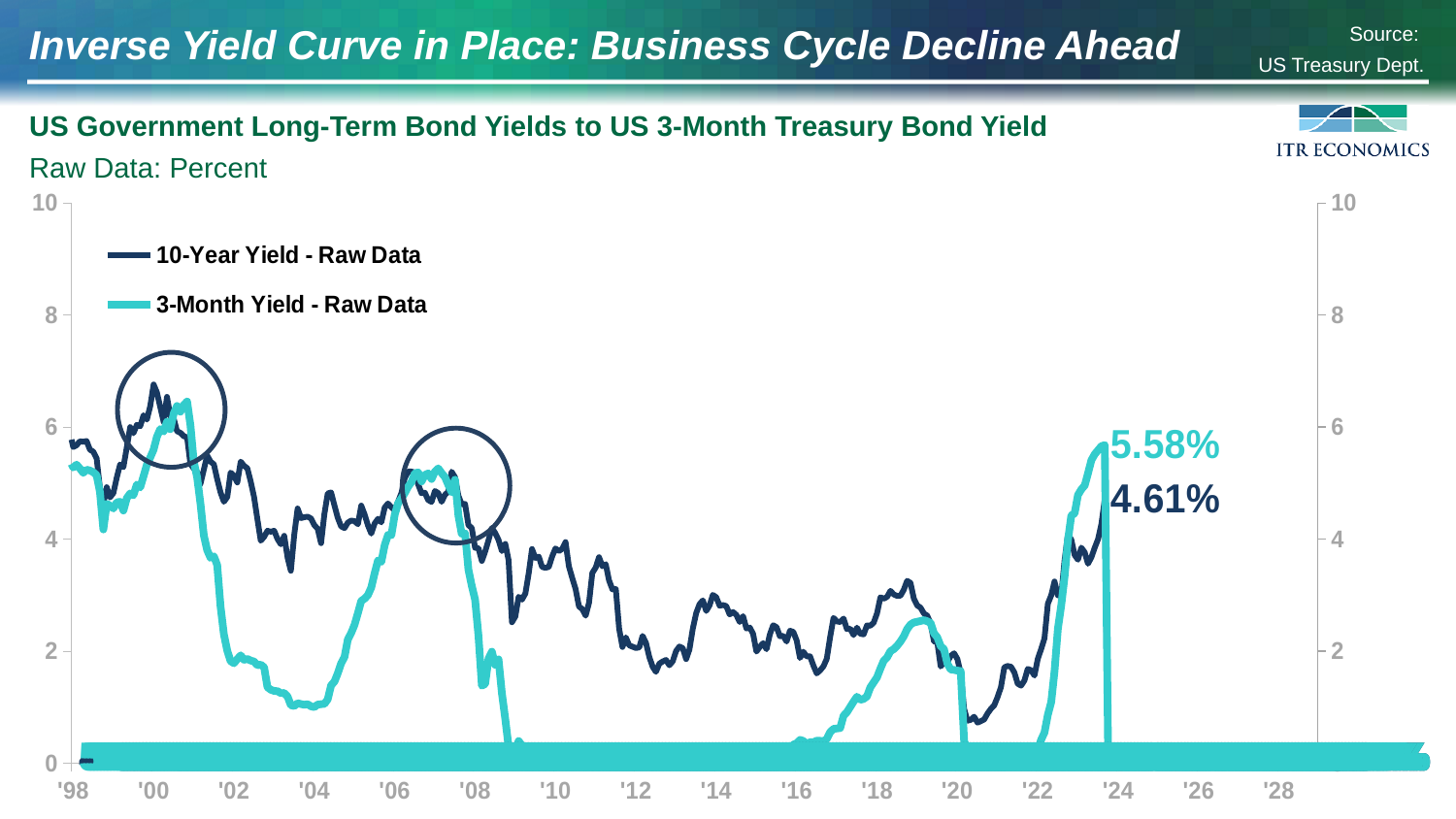
Is the value of the 3-Month Yield - Raw Data series in 2012 greater or less than 2? less What is the latest labelled value for the 10-Year Yield - Raw Data series? 4.61% Is the value of the 10-Year Yield - Raw Data series in 2012 greater or less than 4? less What is the difference between the labelled 3-Month Yield value (5.58%) and the labelled 10-Year Yield value (4.61%)? 0.97% Is the value of the 10-Year Yield - Raw Data series in 1998 greater or less than 4? greater Does the 3-Month Yield - Raw Data series rise or fall between 2020 and 2023? rise At the end of the plotted data, which series is higher: the 3-Month Yield or the 10-Year Yield? 3-Month Yield How many series does the legend list? 2 What is the source of the chart data given on the slide? US Treasury Dept. What kind of chart is shown on the slide? line chart What is the latest labelled value for the 3-Month Yield - Raw Data series? 5.58% What is the title of the chart? US Government Long-Term Bond Yields to US 3-Month Treasury Bond Yield